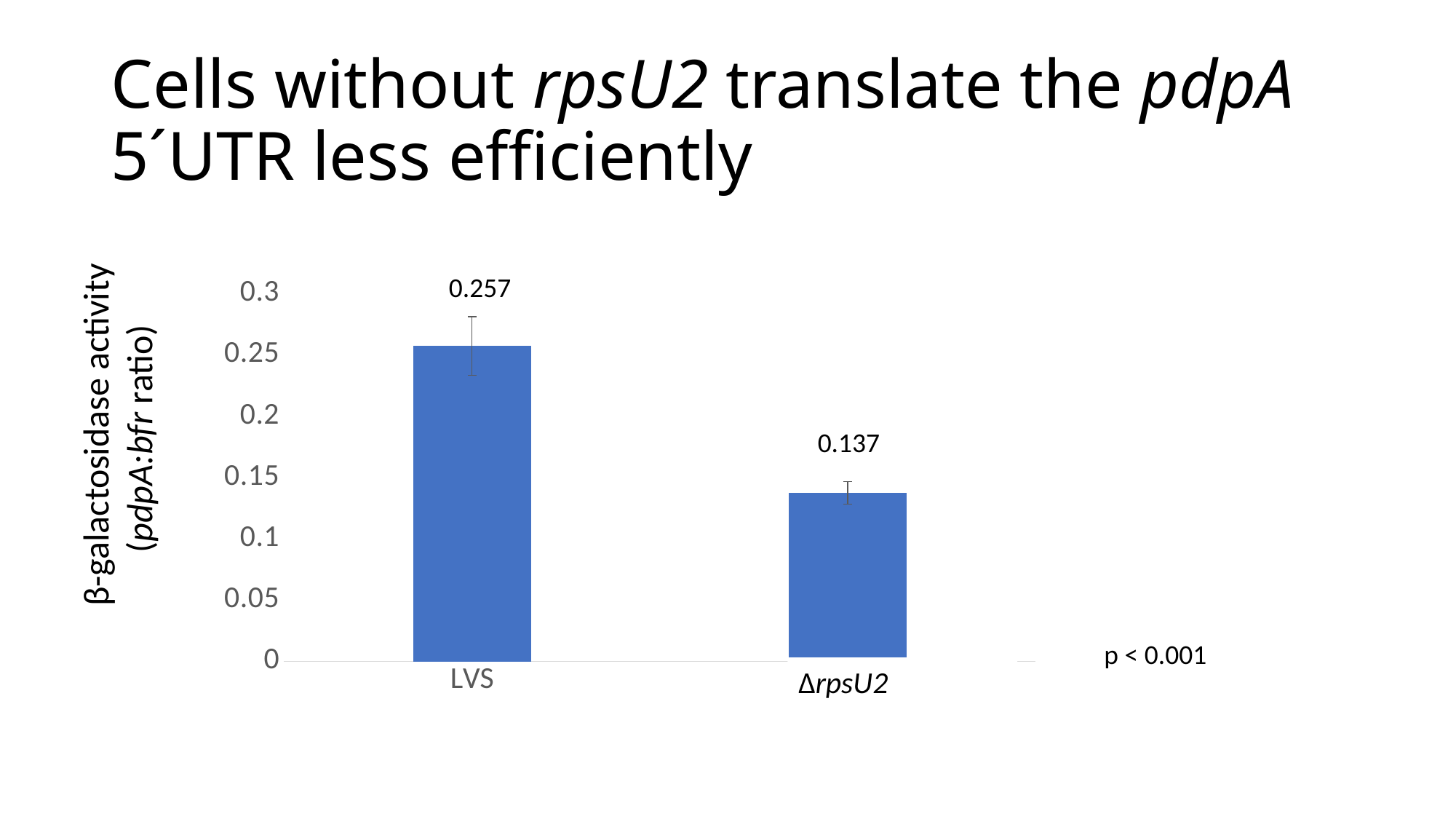
What is the β-galactosidase activity value for LVS? 0.257 Is the value for LVS greater or less than 0.2? greater Which category has the lowest β-galactosidase activity? ΔrpsU2 What is the β-galactosidase activity value for ΔrpsU2? 0.137 Which is larger, the value for LVS or the value for ΔrpsU2? LVS What p-value is stated next to the chart? p < 0.001 Which category has the highest β-galactosidase activity? LVS How many categories are shown on the x axis? 2 Is the value for ΔrpsU2 greater or less than 0.15? less What kind of chart is shown on the slide? bar chart What is the difference between the LVS and ΔrpsU2 values? 0.120 What is the label of the y axis? β-galactosidase activity (pdpA:bfr ratio)